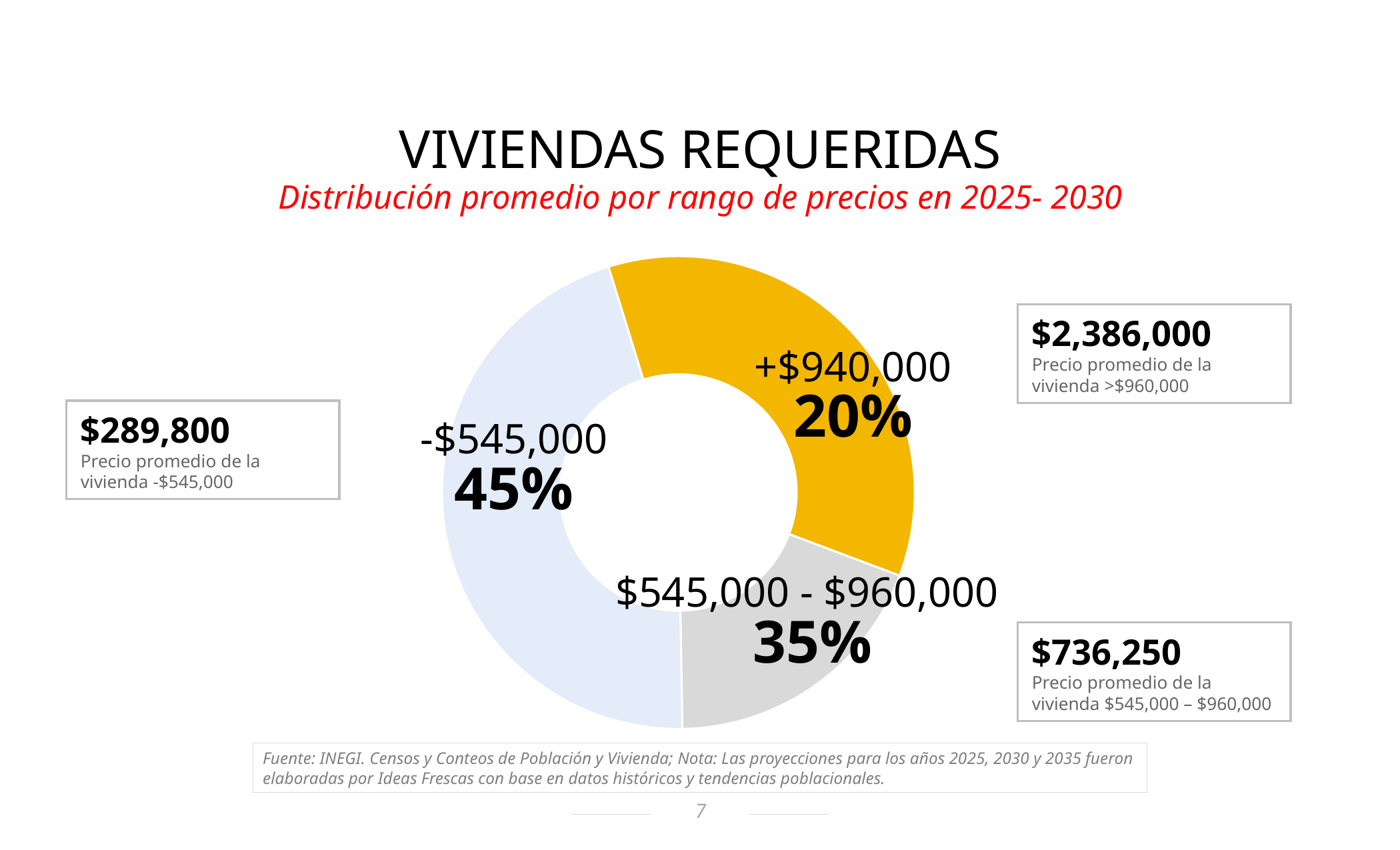
What share of the chart does the $545,000 - $960,000 price range represent? 35% What share of the chart does the +$940,000 price range represent? 20% What kind of chart is shown on the slide? Doughnut (pie) chart Which slice is larger: -$545,000 or $545,000 - $960,000? -$545,000 What is the difference in percentage points between the -$545,000 slice and the +$940,000 slice? 25 percentage points What is the red subtitle of the chart? Distribución promedio por rango de precios en 2025- 2030 What is the difference in percentage points between the $545,000 - $960,000 slice and the +$940,000 slice? 15 percentage points Which price range has the smallest share of the chart? +$940,000 What colour is the +$940,000 slice? Yellow (gold) Which price range has the largest share of the chart? -$545,000 What share of the chart does the -$545,000 price range represent? 45% How many price-range slices does the chart have? 3